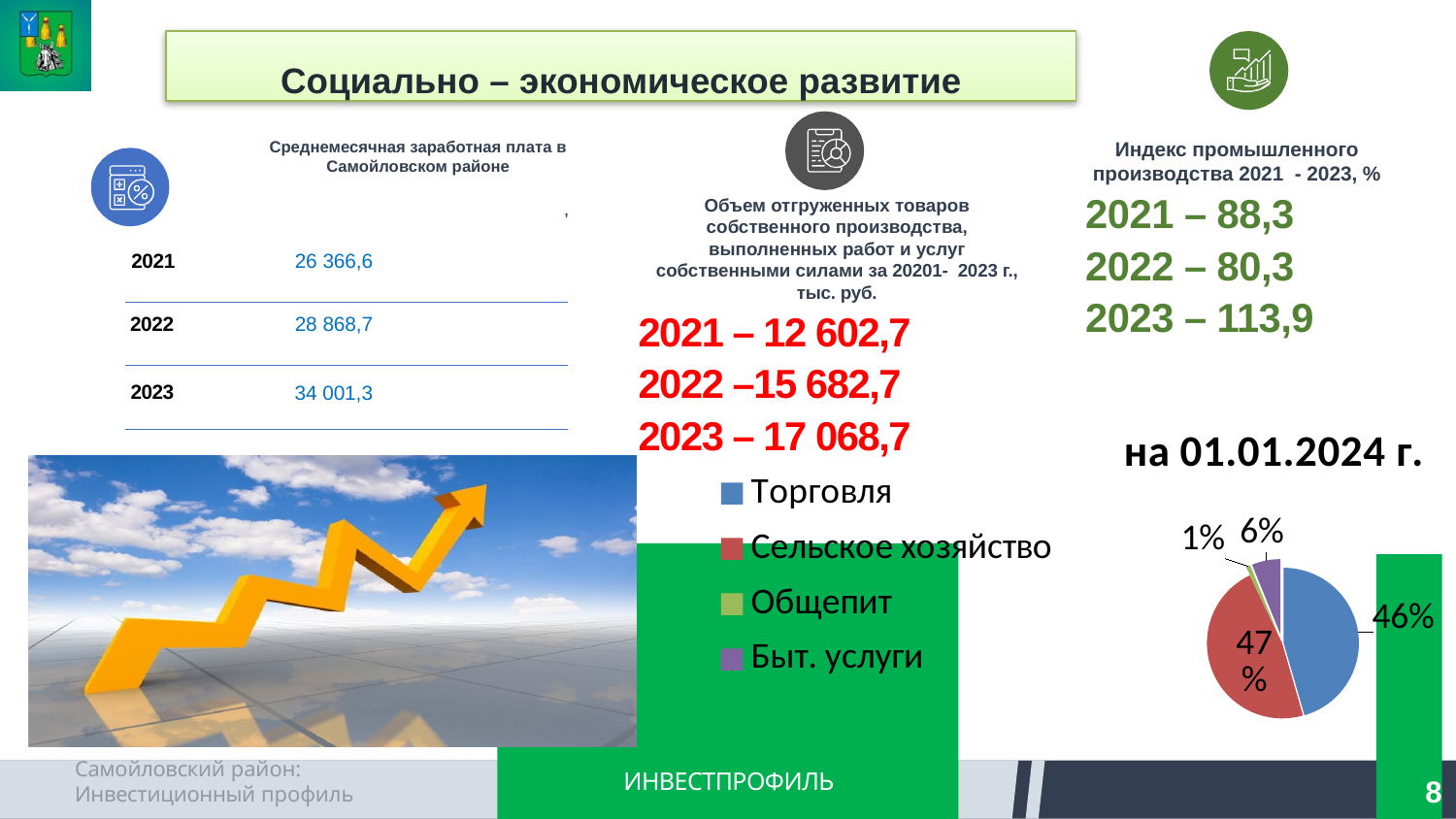
In the pie chart dated 01.01.2024, which is larger: the share of Быт. услуги or the share of Общепит? Быт. услуги In the pie chart, which colour represents Торговля? blue What kind of chart is shown at the bottom right of the slide? pie chart In the pie chart dated 01.01.2024, what share does Сельское хозяйство have? 47% How many categories does the legend of the pie chart list? 4 In the pie chart dated 01.01.2024, what is the difference in percentage points between Быт. услуги and Общепит? 5% In the pie chart dated 01.01.2024, which category has the smallest share? Общепит In the pie chart dated 01.01.2024, what share does Торговля have? 46% In the pie chart dated 01.01.2024, what is the difference in percentage points between Сельское хозяйство and Торговля? 1% In the pie chart dated 01.01.2024, what share does Общепит have? 1% In the pie chart dated 01.01.2024, what share does Быт. услуги have? 6% In the pie chart dated 01.01.2024, which category has the largest share? Сельское хозяйство